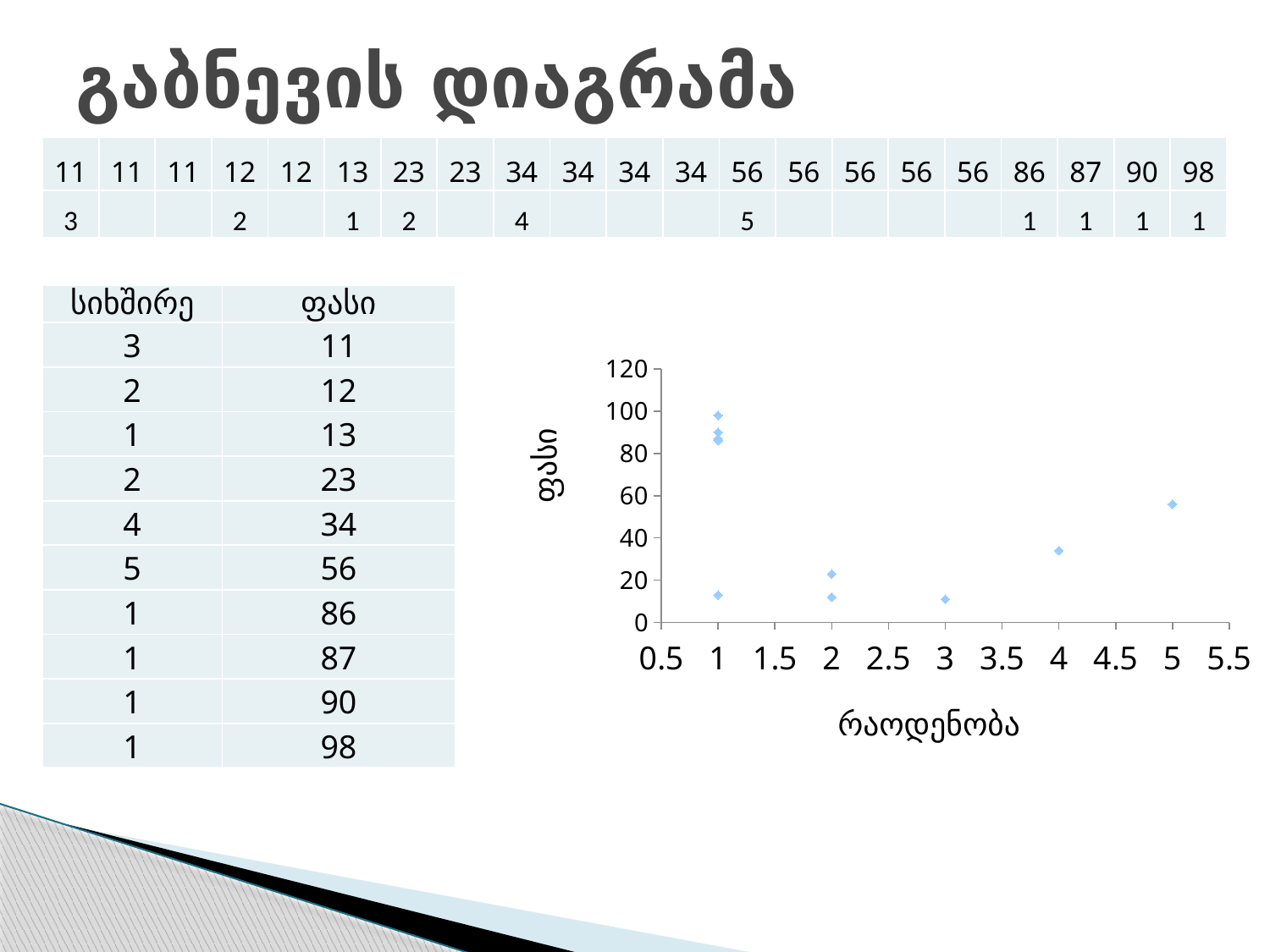
How many data points are plotted at x = 1? 5 How many data points are plotted on the chart? 10 At which x value is the highest point on the chart located? 1 What is the title of the x axis of the chart? რაოდენობა Which has the larger value: the point at x = 5 or the point at x = 4? the point at x = 5 Is the value of the point at x = 3 greater or less than 20? less What kind of chart is shown on the slide? scatter chart Is the value of the point at x = 5 greater or less than 40? greater How many data points are plotted at x = 2? 2 What is the title of the y axis of the chart? ფასი Is the value of the point at x = 4 greater or less than 20? greater